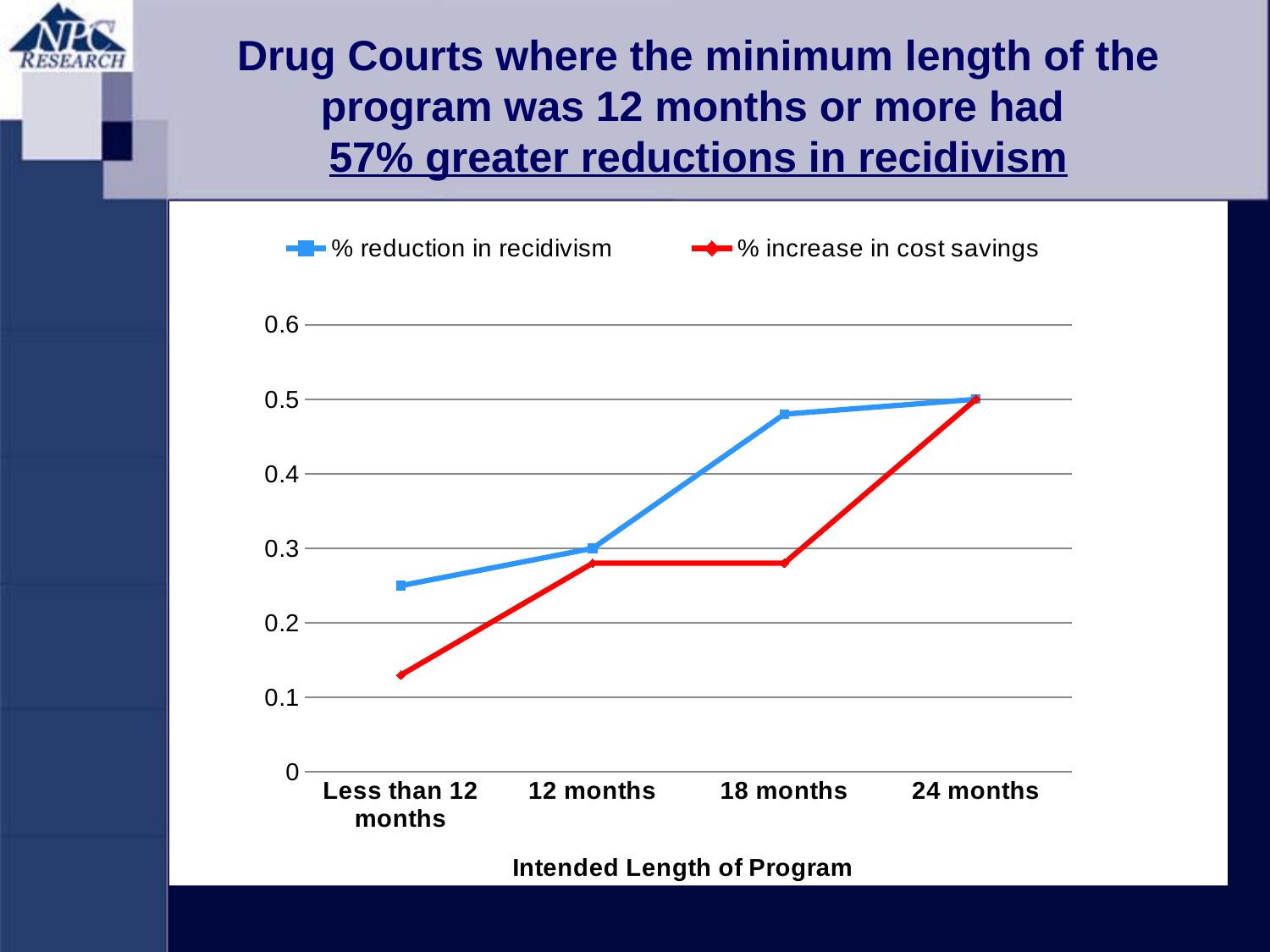
Which program length has the lowest value for % increase in cost savings? Less than 12 months Is the value of % reduction in recidivism for 18 months greater or less than 0.4? greater How many categories are shown on the x axis? 4 Which series is drawn in red? % increase in cost savings Is the value of % reduction in recidivism for Less than 12 months greater or less than 0.3? less How many series does the legend list? 2 Is the value of % increase in cost savings for Less than 12 months greater or less than 0.2? less What kind of chart is shown on the slide? line chart At Less than 12 months, which series has the larger value, % reduction in recidivism or % increase in cost savings? % reduction in recidivism Which program length has the highest value for % reduction in recidivism? 24 months What is the title of the x axis? Intended Length of Program